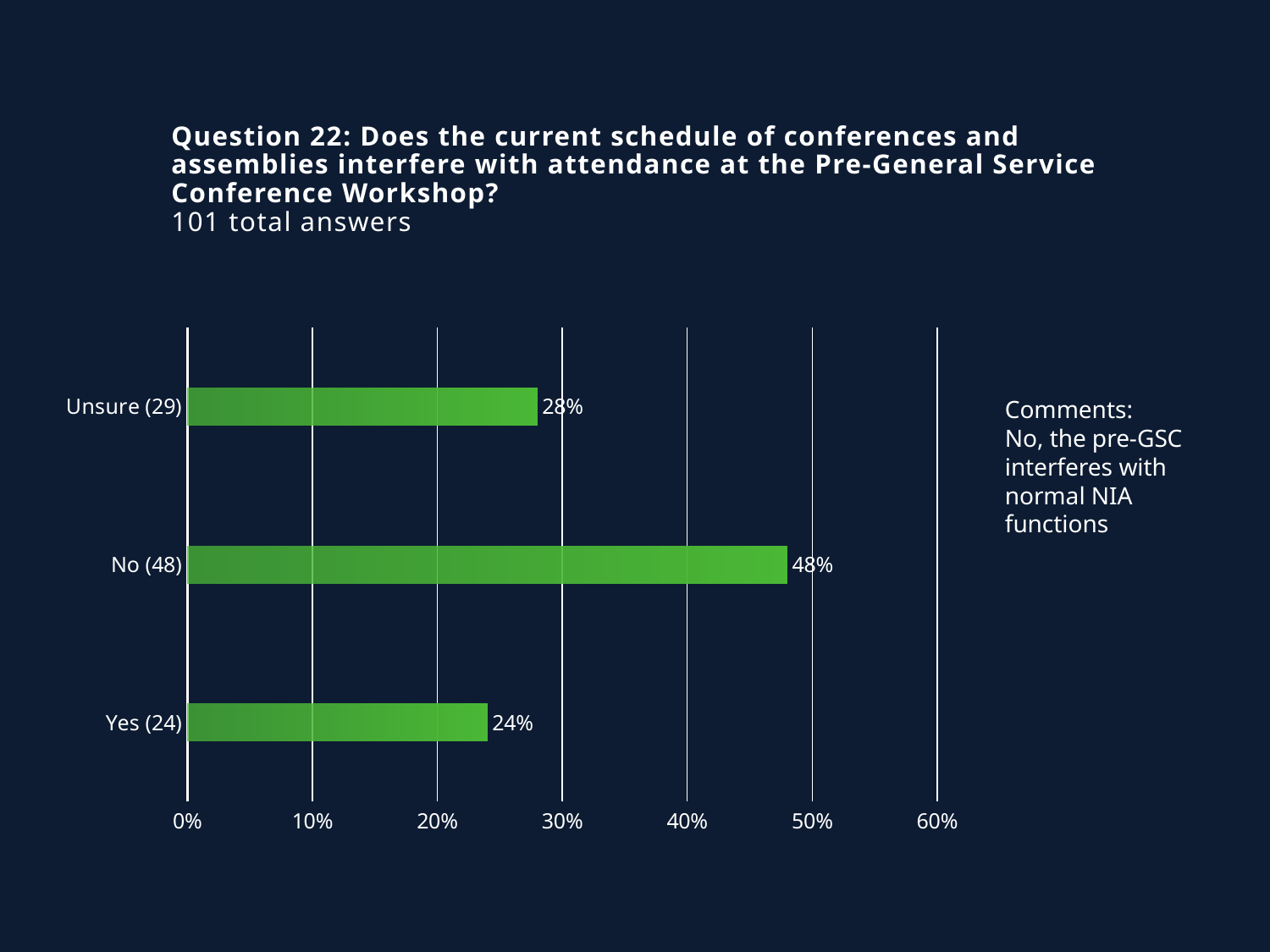
What is the difference in percentage points between the "No" and "Yes" responses? 24 Is the value for "No" greater or less than 40%? greater How many response categories are shown in the chart? 3 What kind of chart is shown on the slide? Bar chart What percentage of respondents answered "Yes"? 24% What percentage of respondents answered "Unsure"? 28% What percentage of respondents answered "No"? 48% Which is larger, the percentage for "Unsure" or the percentage for "Yes"? Unsure Which response category has the highest percentage? No Which response category has the lowest percentage? Yes What is the difference in percentage points between the "Unsure" and "Yes" responses? 4 How many total answers does the slide report for Question 22? 101